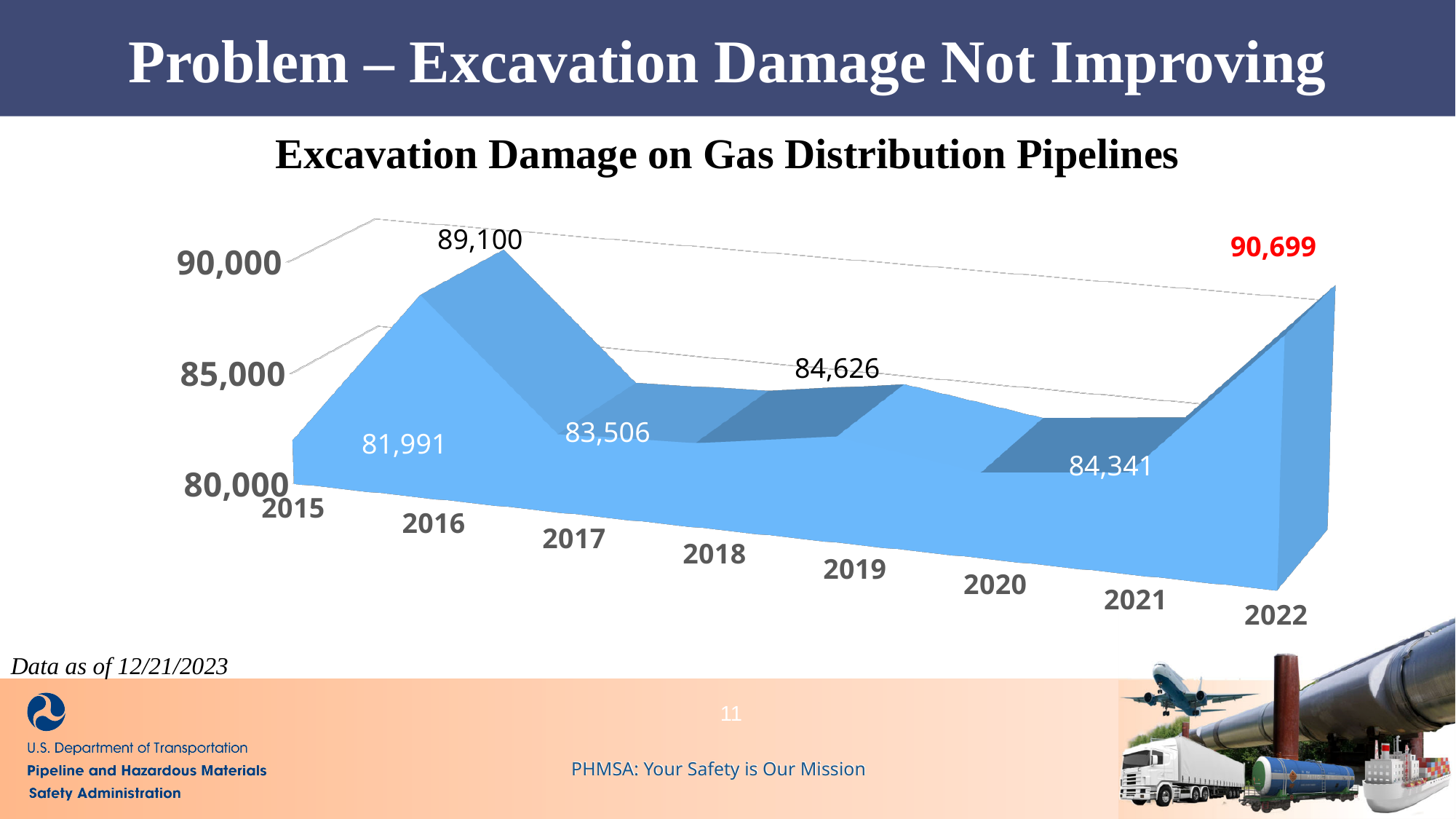
Which is larger, the value for 2016 or the value for 2022? 2022 Which year has the highest excavation damage value? 2022 What is the excavation damage value for 2022? 90,699 Which year has the lowest excavation damage value? 2015 Which data label on the chart is shown in red? 90,699 What is the difference between the 2022 value (90,699) and the 2016 value (89,100)? 1,599 Is the value for 2018 greater or less than 85,000? less How many years are plotted along the x axis of the chart? 8 What is the title of the chart? Excavation Damage on Gas Distribution Pipelines What kind of chart is shown on the slide? area chart What is the excavation damage value for 2016? 89,100 What is the excavation damage value for 2015? 81,991